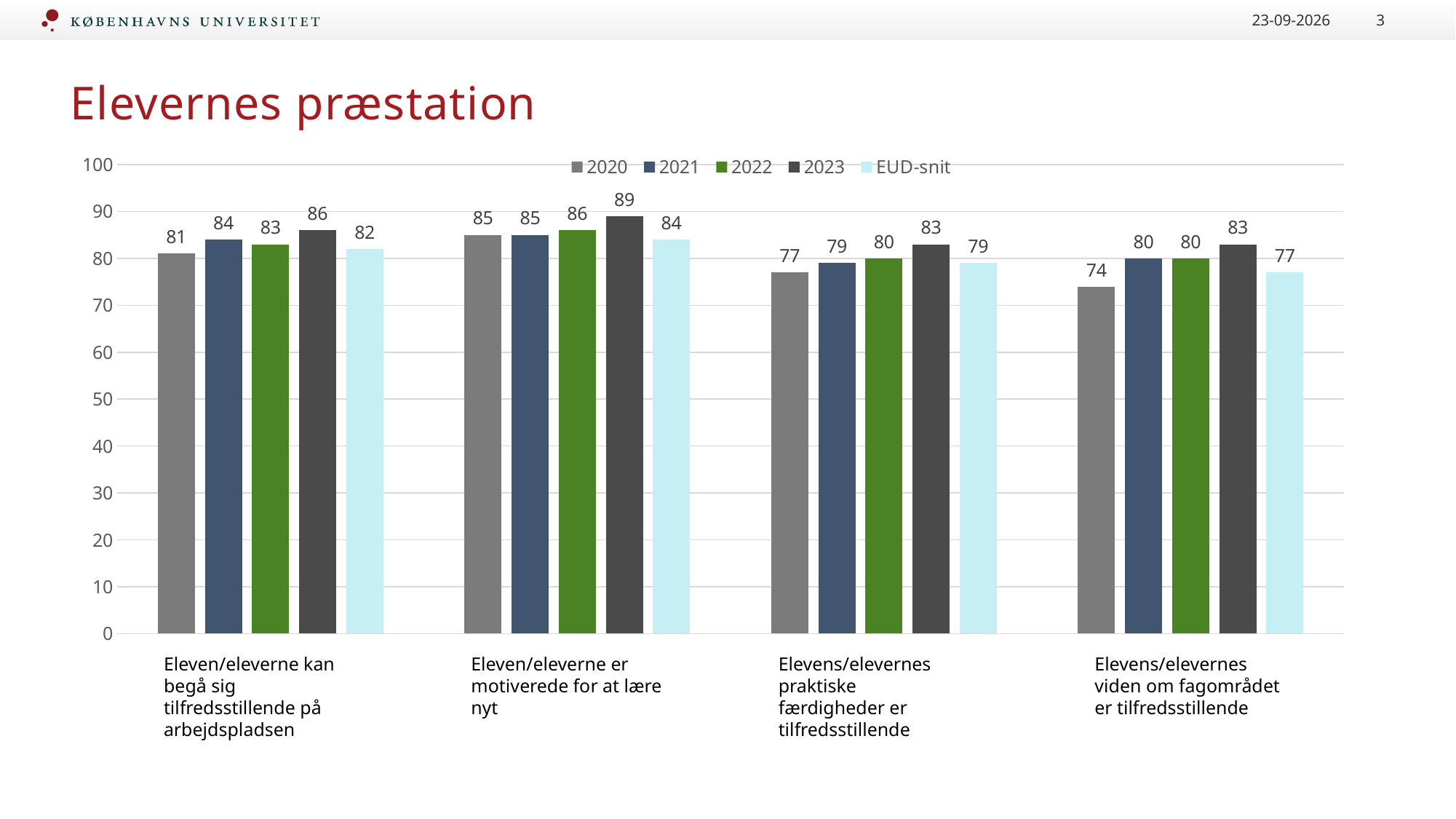
Which is larger for "Eleven/eleverne kan begå sig tilfredsstillende på arbejdspladsen": the 2021 value or the 2022 value? 2021 What is the EUD-snit value for "Elevens/elevernes praktiske færdigheder er tilfredsstillende"? 79 Which category has the lowest 2020 value? Elevens/elevernes viden om fagområdet er tilfredsstillende What is the title of the slide? Elevernes præstation Is the 2020 value for "Elevens/elevernes praktiske færdigheder er tilfredsstillende" greater or less than 80? less How many series does the legend list? 5 What is the 2020 value for "Elevens/elevernes viden om fagområdet er tilfredsstillende"? 74 What is the difference between the 2023 and 2020 values for "Elevens/elevernes viden om fagområdet er tilfredsstillende"? 9 What kind of chart is shown on the slide? bar chart What is the 2023 value for "Eleven/eleverne er motiverede for at lære nyt"? 89 How many categories are shown on the x axis? 4 Which category has the highest 2023 value? Eleven/eleverne er motiverede for at lære nyt